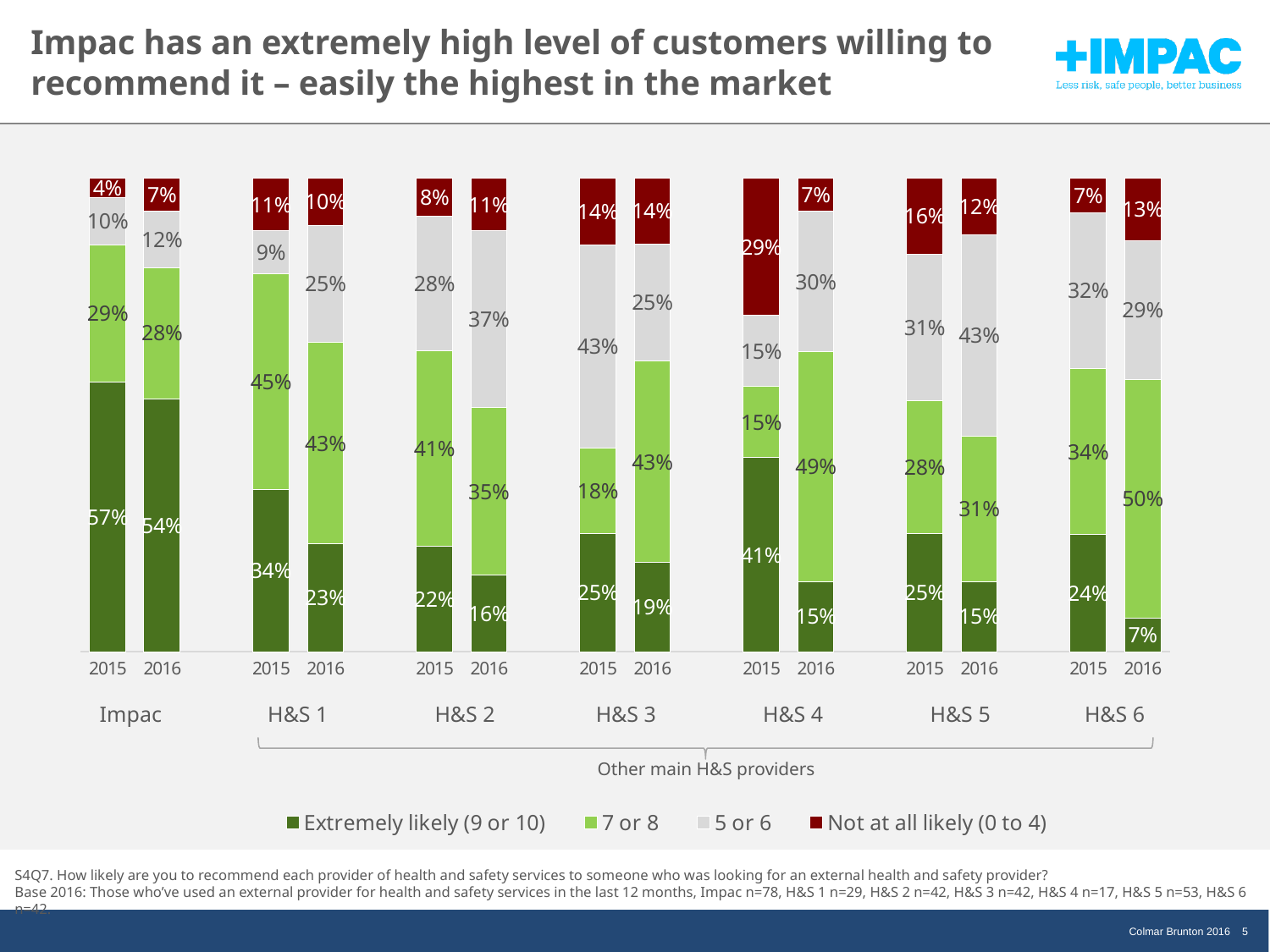
What kind of chart is shown on the slide? Stacked bar chart What is the difference between the 'Extremely likely (9 or 10)' values for Impac and H&S 1 in 2016? 31 percentage points What is the '7 or 8' value for H&S 6 in 2016? 50% What is the 'Not at all likely (0 to 4)' value for H&S 4 in 2015? 29% How many providers are compared on the chart? 7 Which provider has the highest 'Extremely likely (9 or 10)' share in 2016? Impac By how many percentage points did Impac's 'Extremely likely (9 or 10)' share change from 2015 to 2016? 3 percentage points lower (57% to 54%) What is the '5 or 6' value for H&S 5 in 2016? 43% Which is larger: the 'Not at all likely (0 to 4)' value for H&S 3 in 2016 or for H&S 5 in 2016? H&S 3 (14%) What percentage of Impac customers in 2016 were 'Extremely likely (9 or 10)' to recommend it? 54% Which provider has the lowest 'Extremely likely (9 or 10)' share in 2016? H&S 6 How many series does the legend list? 4